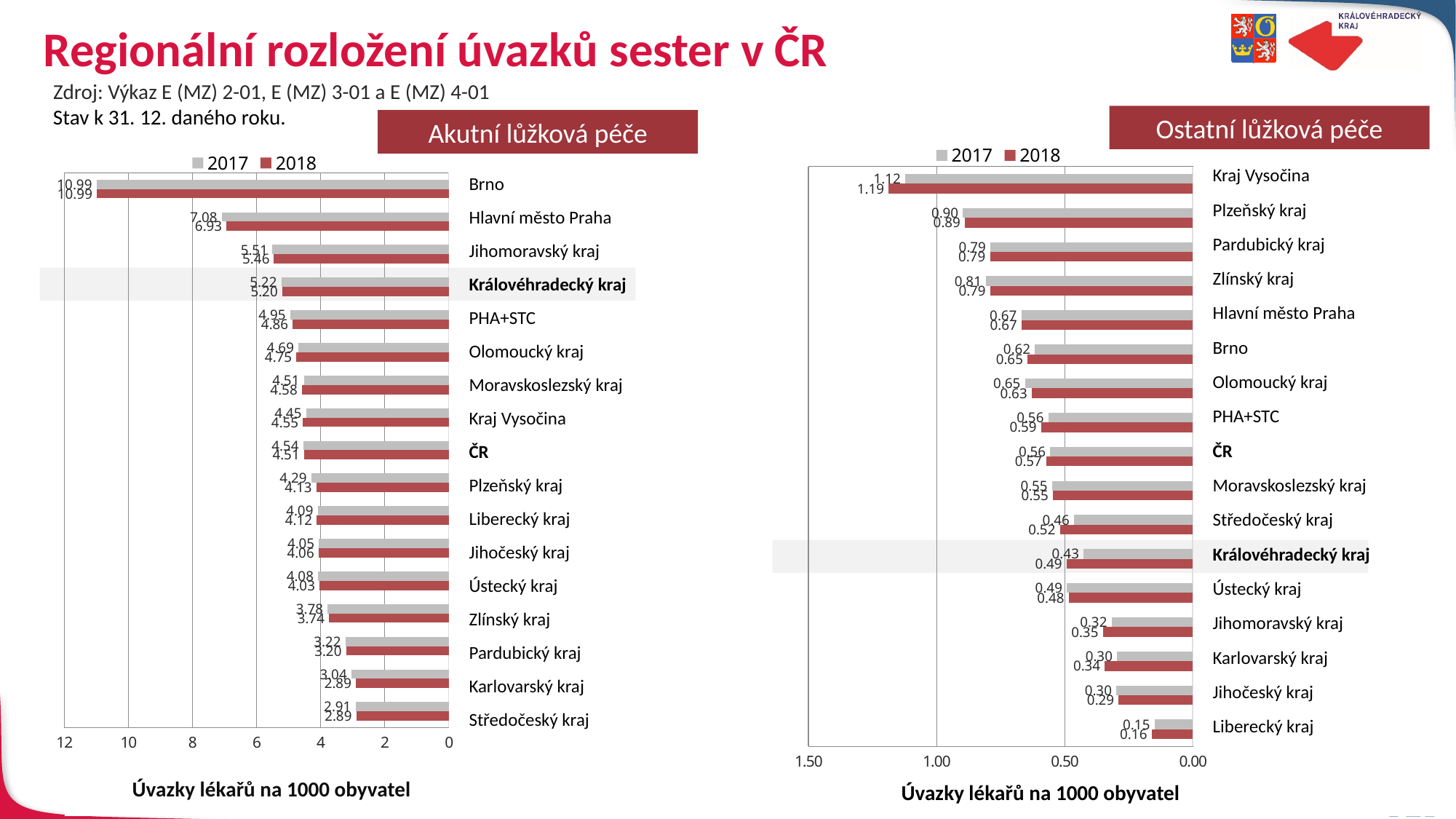
In the 'Akutní lůžková péče' chart, what is the 2017 value for Hlavní město Praha? 7.08 In the 'Akutní lůžková péče' chart, what is the difference between the 2017 and 2018 values for Plzeňský kraj? 0.16 In the 'Akutní lůžková péče' chart, which category has the highest 2018 value? Brno In the 'Ostatní lůžková péče' chart, which is larger for Brno: the 2017 value or the 2018 value? 2018 How many series does the legend of the 'Ostatní lůžková péče' chart list? 2 In the 'Akutní lůžková péče' chart, which category has the lowest 2017 value? Středočeský kraj In the 'Akutní lůžková péče' chart, how many categories are shown? 17 In the 'Akutní lůžková péče' chart, what is the 2018 value for Královéhradecký kraj? 5.20 In the 'Ostatní lůžková péče' chart, what is the 2018 value for Kraj Vysočina? 1.19 In the 'Ostatní lůžková péče' chart, what is the 2017 value for Královéhradecký kraj? 0.43 In the 'Ostatní lůžková péče' chart, which category has the lowest 2018 value? Liberecký kraj What type of chart is the 'Akutní lůžková péče' chart? Bar chart